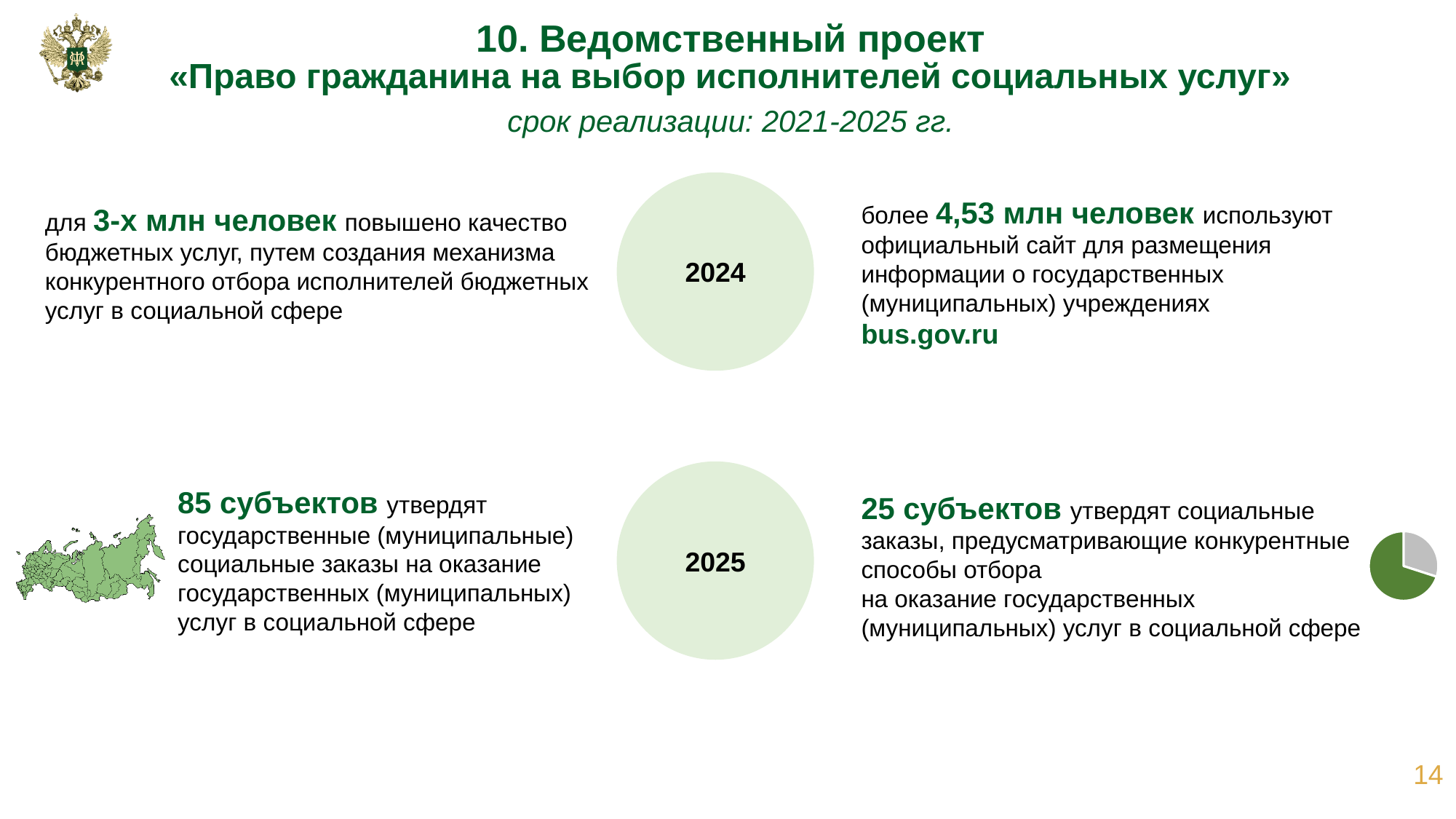
In the pie chart at the bottom right of the slide, which slice is larger, the green one or the grey one? the green one What colours are the slices of the pie chart at the bottom right of the slide? green and grey What kind of chart is shown at the bottom right of the slide? pie chart How many slices does the pie chart at the bottom right of the slide have? 2